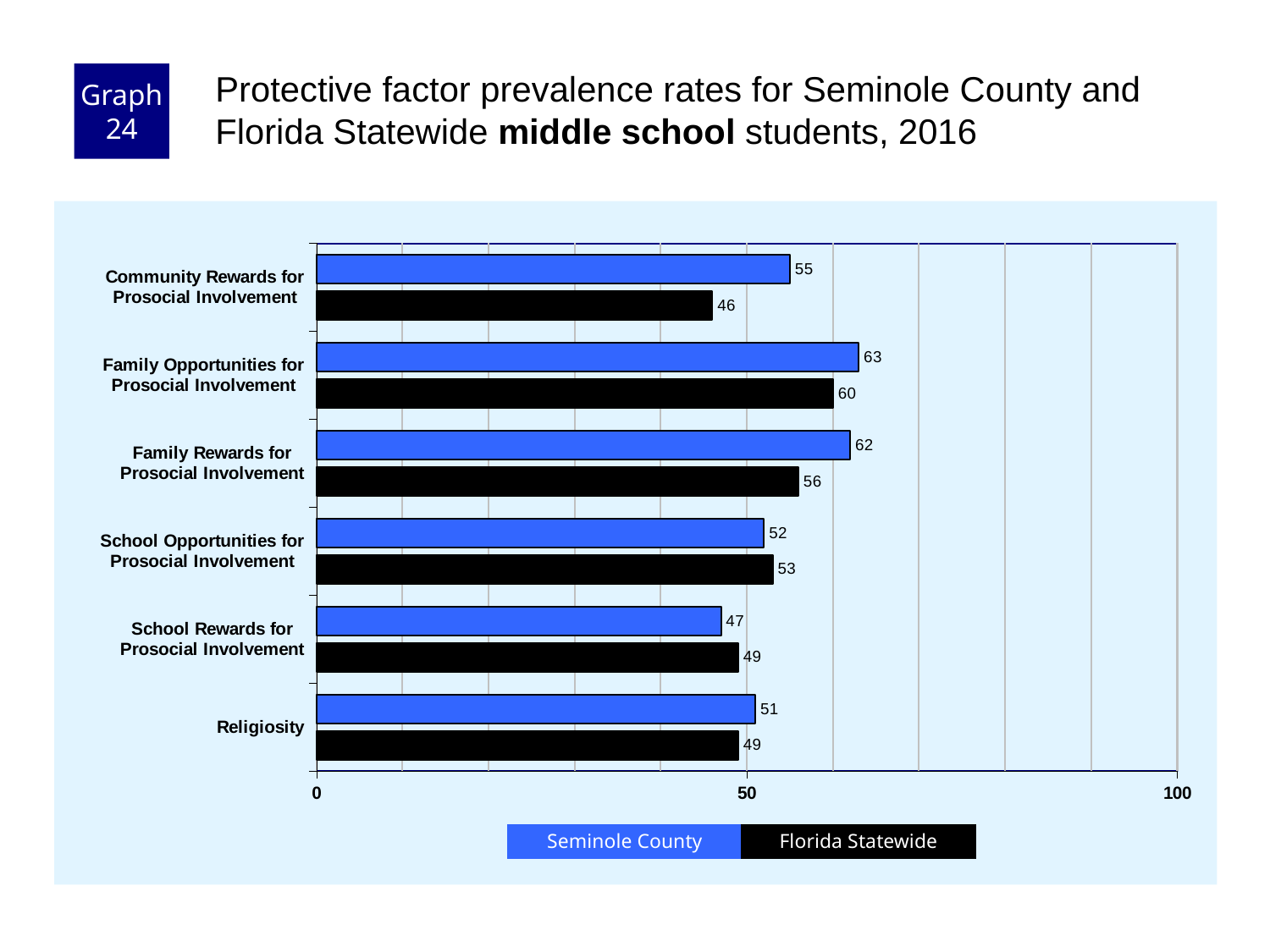
What is the difference between the Seminole County and Florida Statewide values for Community Rewards for Prosocial Involvement? 9 Which category has the lowest Florida Statewide value? Community Rewards for Prosocial Involvement How many series does the legend list? 2 Is the Seminole County value for Family Rewards for Prosocial Involvement greater or less than 50? greater What is the Seminole County value for Community Rewards for Prosocial Involvement? 55 What is the difference between the Seminole County and Florida Statewide values for Family Rewards for Prosocial Involvement? 6 What kind of chart is shown on the slide? bar chart What is the Florida Statewide value for Family Opportunities for Prosocial Involvement? 60 What is the Florida Statewide value for Religiosity? 49 How many categories are shown on the chart? 6 Which category has the highest Seminole County value? Family Opportunities for Prosocial Involvement For School Rewards for Prosocial Involvement, which is larger: the Seminole County value or the Florida Statewide value? Florida Statewide